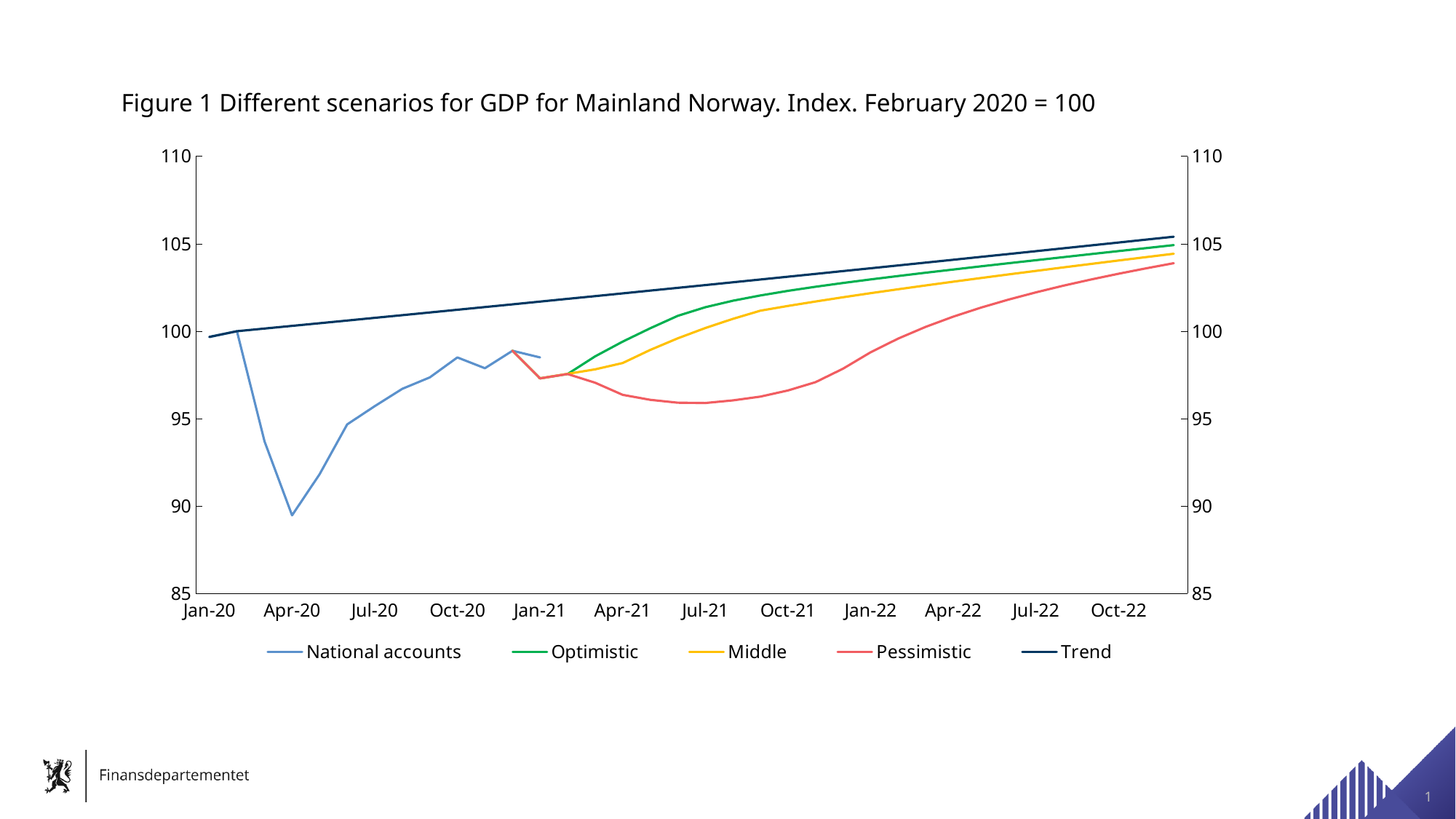
What is the title of the chart? Figure 1 Different scenarios for GDP for Mainland Norway. Index. February 2020 = 100 What kind of chart is shown on the slide? line chart Does the Trend series rise or fall along the x axis? rises Does the Pessimistic series rise or fall between Jan-21 and Jul-21? falls Is the lowest value of the National accounts series greater or less than 90? less Is the value of the Pessimistic series at Jul-21 greater or less than 100? less At Jul-21, which series has the larger value, Optimistic or Middle? Optimistic How many series does the legend list? 5 Is the value of the Optimistic series at Oct-22 greater or less than 100? greater Which series is the lowest at the right-hand end of the chart? Pessimistic At Oct-22, which series has the larger value, Trend or Pessimistic? Trend Which series is the highest at the right-hand end of the chart? Trend